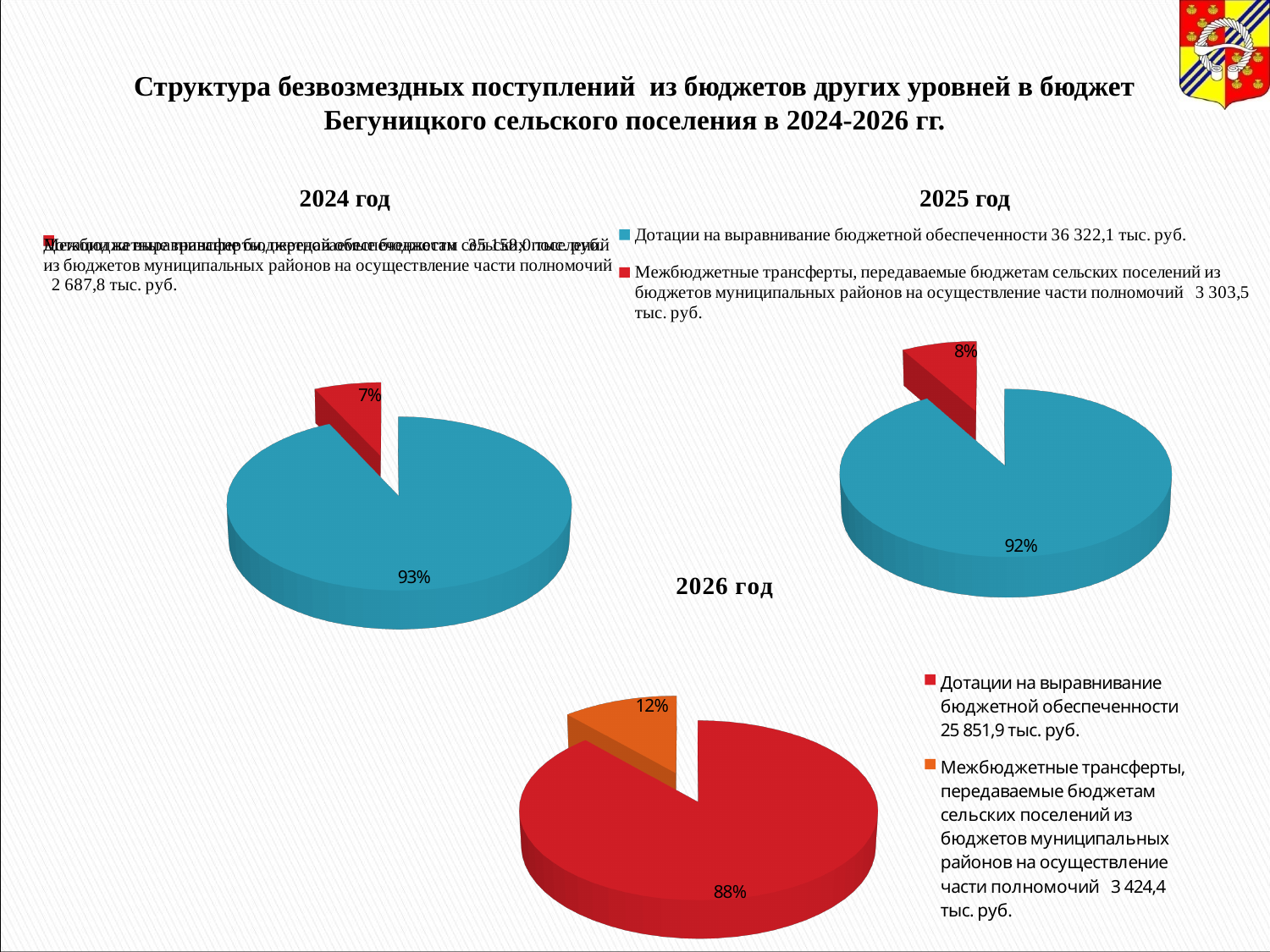
Which is larger: the Межбюджетные трансферты share in the 2025 год chart or in the 2026 год chart? 2026 год According to the 2026 год legend, what is the amount for Межбюджетные трансферты, передаваемые бюджетам сельских поселений? 3 424,4 тыс. руб. In the 2026 год pie chart, what share is labelled on the orange slice? 12% What type of chart is used for the 2024 год chart? pie chart In the 2025 год pie chart, what share is labelled on the red slice? 8% In the 2025 год pie chart, what share is labelled on the blue slice? 92% How many slices does the 2026 год pie chart have? 2 According to the 2025 год legend, what is the amount for Дотации на выравнивание бюджетной обеспеченности? 36 322,1 тыс. руб. Does the share of the smaller slice rise or fall from the 2024 год chart to the 2026 год chart? rise